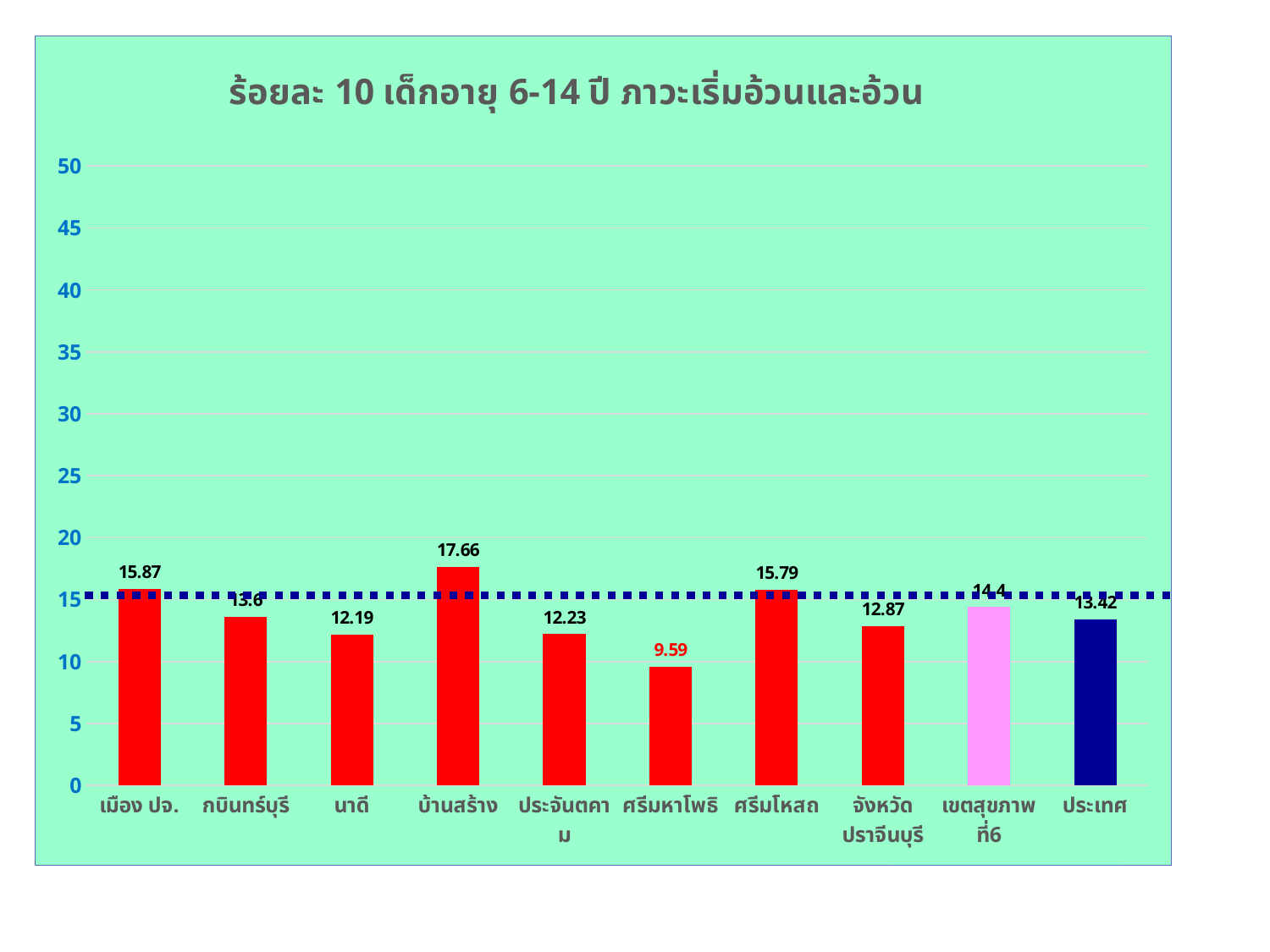
What is the difference between the values for บ้านสร้าง and ศรีมหาโพธิ? 8.07 What is the value for ศรีมหาโพธิ? 9.59 Which category has the highest value? บ้านสร้าง What colour is the bar for เขตสุขภาพที่6? pink What kind of chart is this? bar chart How many categories are shown on the x axis? 10 Which is larger, the value for กบินทร์บุรี or the value for นาดี? กบินทร์บุรี What is the value for ประเทศ? 13.42 Which category has the lowest value? ศรีมหาโพธิ What is the value for บ้านสร้าง? 17.66 Is the value for ศรีมหาโพธิ greater or less than 10? less What is the value for เขตสุขภาพที่6? 14.4